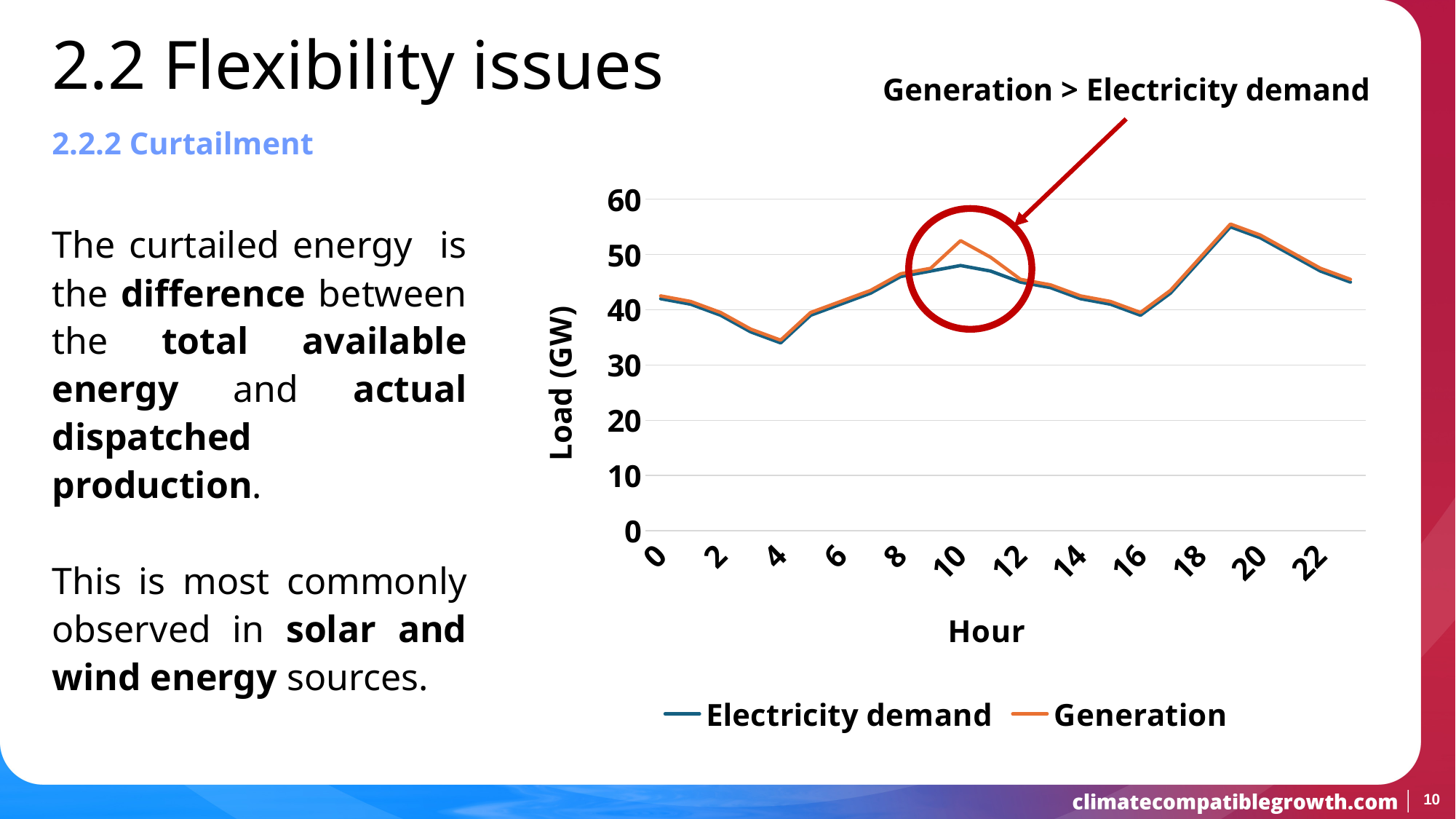
What kind of chart is shown on the slide? Line chart Is the Electricity demand value at hour 4 greater or less than 40? less Is the Electricity demand value at hour 10 greater or less than 50? less Is the Electricity demand value at hour 19 greater or less than 50? greater Do the Electricity demand values rise or fall from hour 0 to hour 4? Fall At which hour does the Electricity demand series reach its lowest value? 4 What are the two series named in the chart's legend? Electricity demand and Generation At hour 10, which series has the larger value, Electricity demand or Generation? Generation How many series does the chart's legend list? 2 What is the title of the chart's vertical axis? Load (GW) Do the Generation values rise or fall from hour 16 to hour 19? Rise